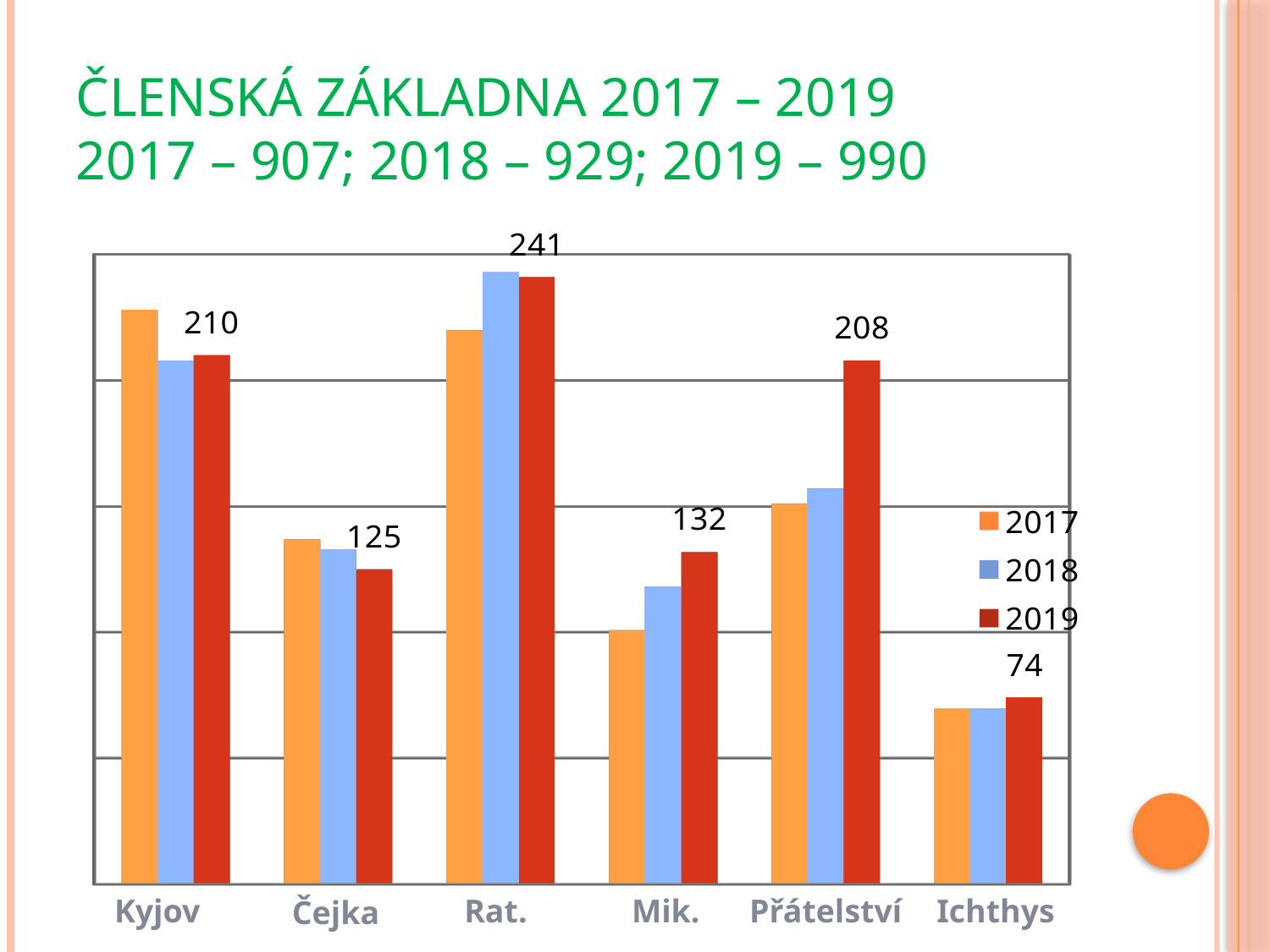
How many series does the legend list? 3 For Kyjov, which bar is taller: 2017 or 2019? 2017 Which category has the lowest 2019 value? Ichthys What is the 2019 value for Mik.? 132 What is the 2019 value for Rat.? 241 Do the values for Přátelství rise or fall from 2017 to 2019? rise What is the difference between the 2019 values for Rat. and Kyjov? 31 Which is larger for 2019: Mik. or Čejka? Mik. What is the 2019 value for Ichthys? 74 Which category has the highest 2019 value? Rat. What is the 2019 value for Přátelství? 208 How many categories are shown on the x axis? 6